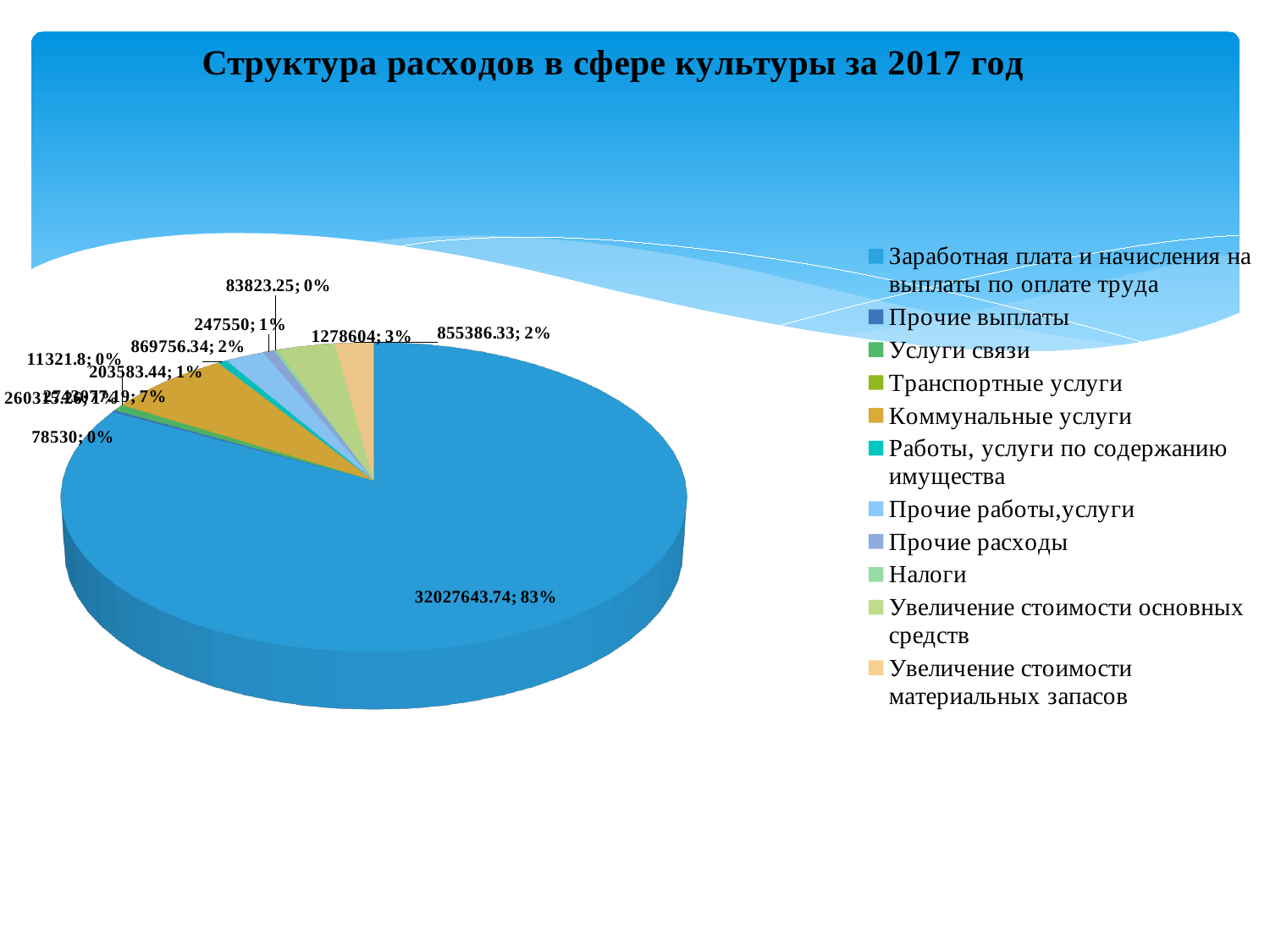
What is the value shown for "Заработная плата и начисления на выплаты по оплате труда"? 32027643.74 What is the value shown for "Увеличение стоимости основных средств"? 1278604 What share of the pie does "Коммунальные услуги" take? 7% Which legend entry is listed first in the pie chart's legend? Заработная плата и начисления на выплаты по оплате труда How many categories does the legend of the pie chart list? 11 What is the title of the chart? Структура расходов в сфере культуры за 2017 год What is the value shown for "Увеличение стоимости материальных запасов"? 855386.33 What share of the pie does "Заработная плата и начисления на выплаты по оплате труда" take? 83% Which category has the largest slice of the pie? Заработная плата и начисления на выплаты по оплате труда Which is larger, the slice for "Заработная плата и начисления на выплаты по оплате труда" or the slice for "Коммунальные услуги"? Заработная плата и начисления на выплаты по оплате труда What kind of chart is shown on the slide? pie chart What share of the pie does "Увеличение стоимости основных средств" take? 3%